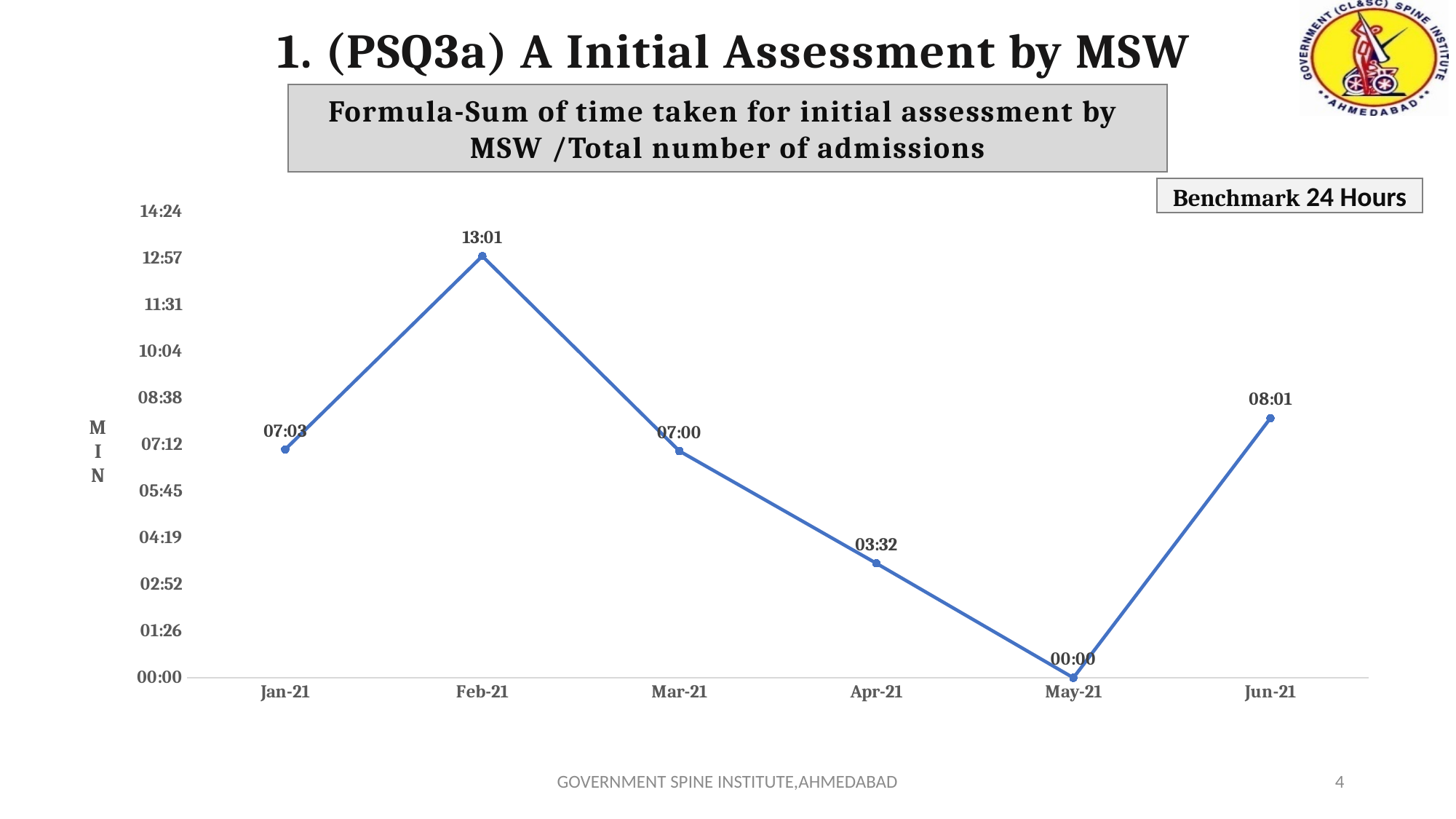
What benchmark is stated on the slide? 24 Hours Which month has the highest value? Feb-21 What is the value for Jan-21? 07:03 Which is larger, the value for Mar-21 or the value for Jun-21? Jun-21 What is the y-axis label of the chart? MIN What is the value for Feb-21? 13:01 Which month has the lowest value? May-21 What is the value for Jun-21? 08:01 What kind of chart is shown on the slide? Line chart How many months are plotted on the chart? 6 What is the value for Apr-21? 03:32 Do the values rise or fall from Feb-21 to May-21? Fall